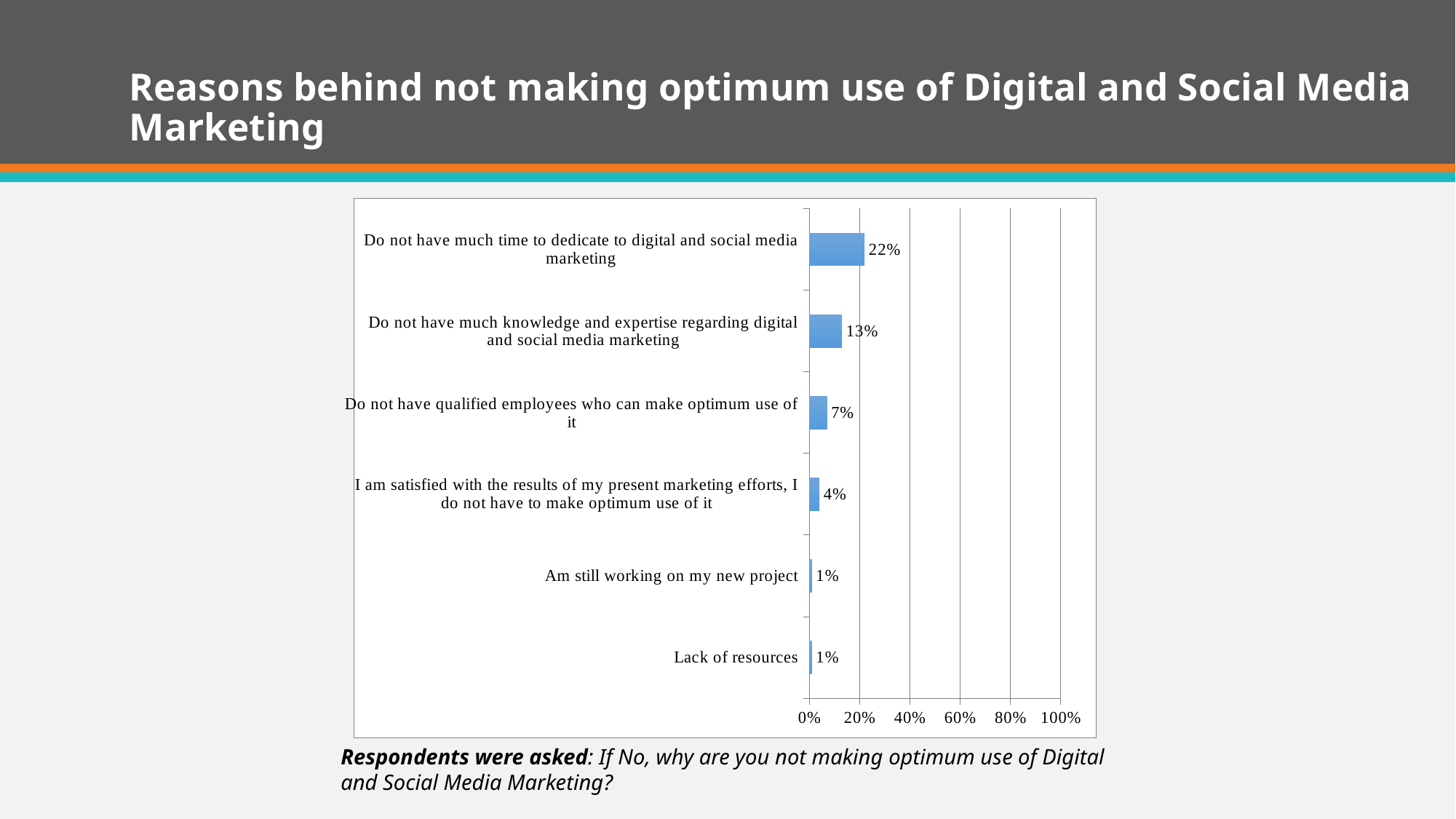
What is the maximum value shown on the horizontal axis? 100% What is the value for 'Do not have much knowledge and expertise regarding digital and social media marketing'? 13% What kind of chart is shown on the slide? Bar chart What is the difference between the 'Do not have much time' bar and the 'Do not have much knowledge and expertise' bar? 9% How many reasons (categories) are shown in the chart? 6 Which reason has the highest percentage? Do not have much time to dedicate to digital and social media marketing What is the value for 'Am still working on my new project'? 1% What percentage is shown for 'Do not have qualified employees who can make optimum use of it'? 7% What is the difference between the 'Do not have qualified employees' value and the 'Lack of resources' value? 6% Is the value for 'Do not have much time to dedicate to digital and social media marketing' greater or less than 40%? less Which is larger: the value for 'Do not have qualified employees' or the value for 'I am satisfied with the results of my present marketing efforts'? Do not have qualified employees who can make optimum use of it What percentage of respondents said they do not have much time to dedicate to digital and social media marketing? 22%